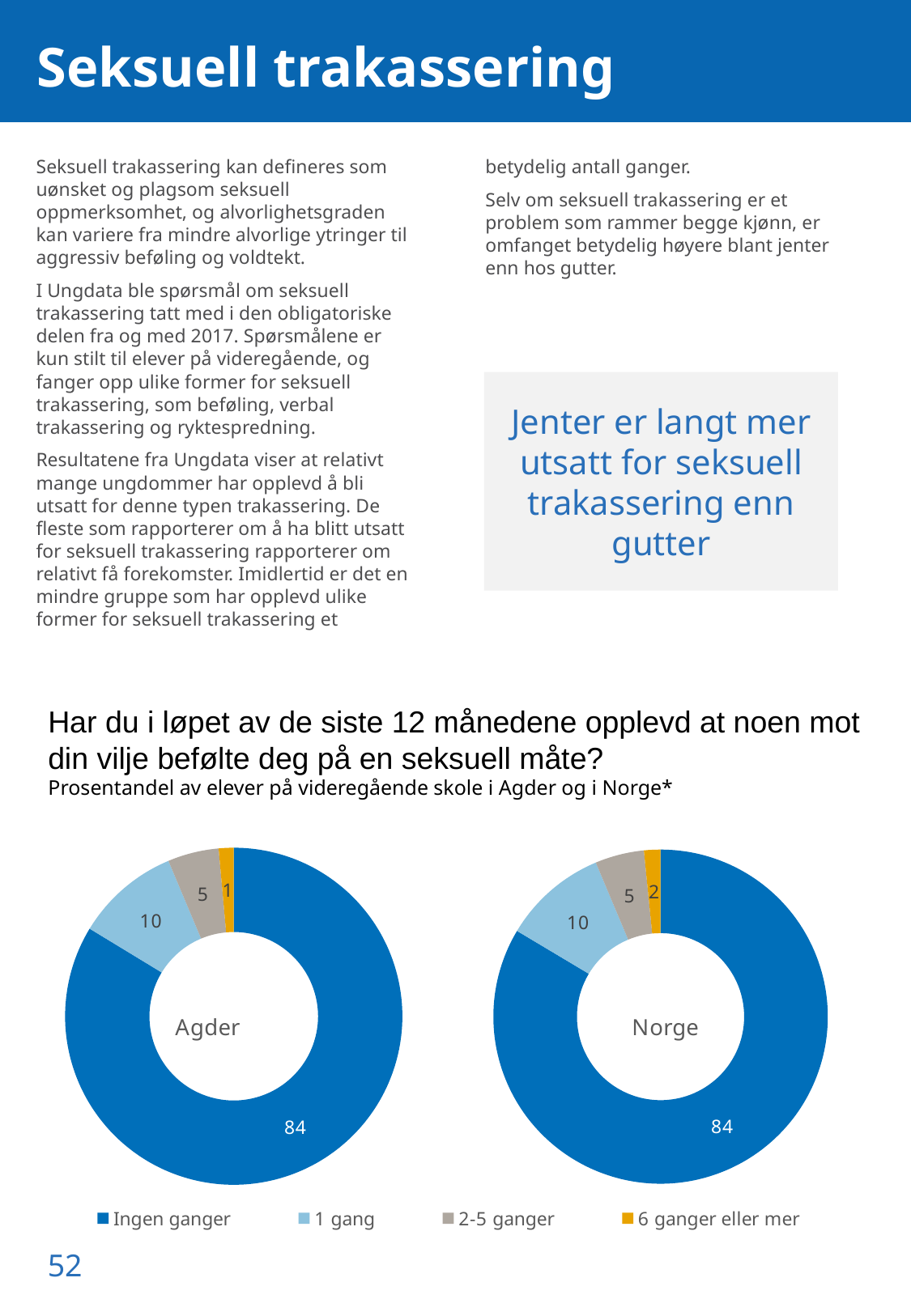
In the Agder chart, which category has the largest share? Ingen ganger In the Agder chart, what is the value for 'Ingen ganger'? 84 Which colour represents '6 ganger eller mer' in the legend? Orange/yellow In the Norge chart, which category has the smallest share? 6 ganger eller mer How many categories does the legend list for the charts? 4 In the Agder chart, which is larger: '1 gang' or '2-5 ganger'? 1 gang In the Agder chart, what is the difference between 'Ingen ganger' and '1 gang'? 74 In the Norge chart, what is the value for '2-5 ganger'? 5 In the Agder chart, what is the value for '1 gang'? 10 What is the difference between the '6 ganger eller mer' value in the Norge chart and the '6 ganger eller mer' value in the Agder chart? 1 In the Norge chart, what is the value for '6 ganger eller mer'? 2 What kind of chart is used for Agder and Norge? Donut (pie) chart